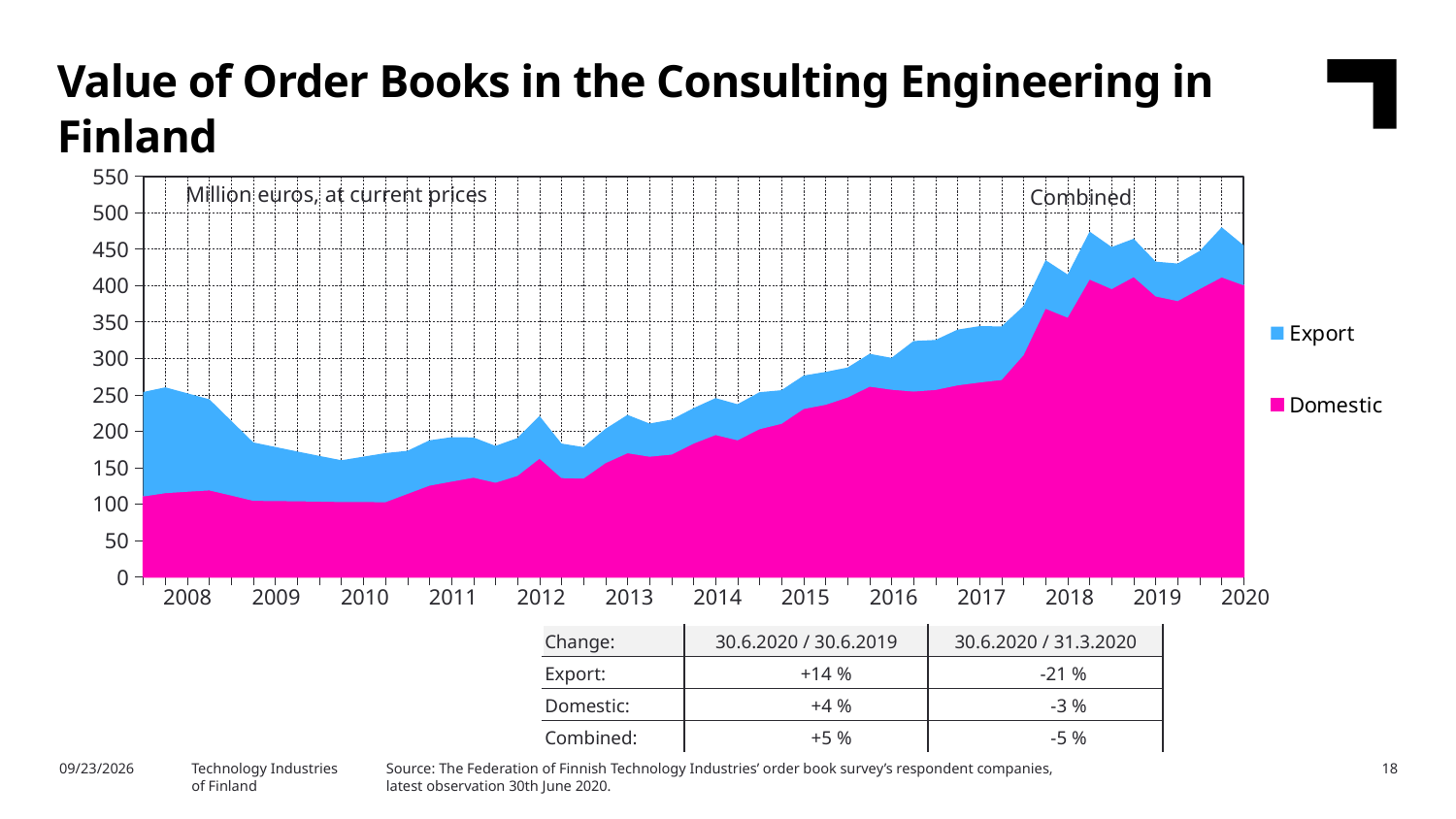
Is the Domestic value in 2016 greater or less than 200? greater Is the Combined value in 2018 greater or less than 400? greater What kind of chart is shown on the slide? Stacked area chart Is the Combined value at the start of 2008 greater or less than 200? greater What are the two series named in the legend? Export and Domestic In what unit are the values on the chart expressed, according to the note inside the plot area? Million euros, at current prices How many series does the legend list? 2 Which series is larger in 2020, Export or Domestic? Domestic How many years are labelled on the x axis? 13 Is the Domestic value larger in 2020 or in 2008? 2020 Does the Combined value rise or fall between 2012 and 2020? Rise